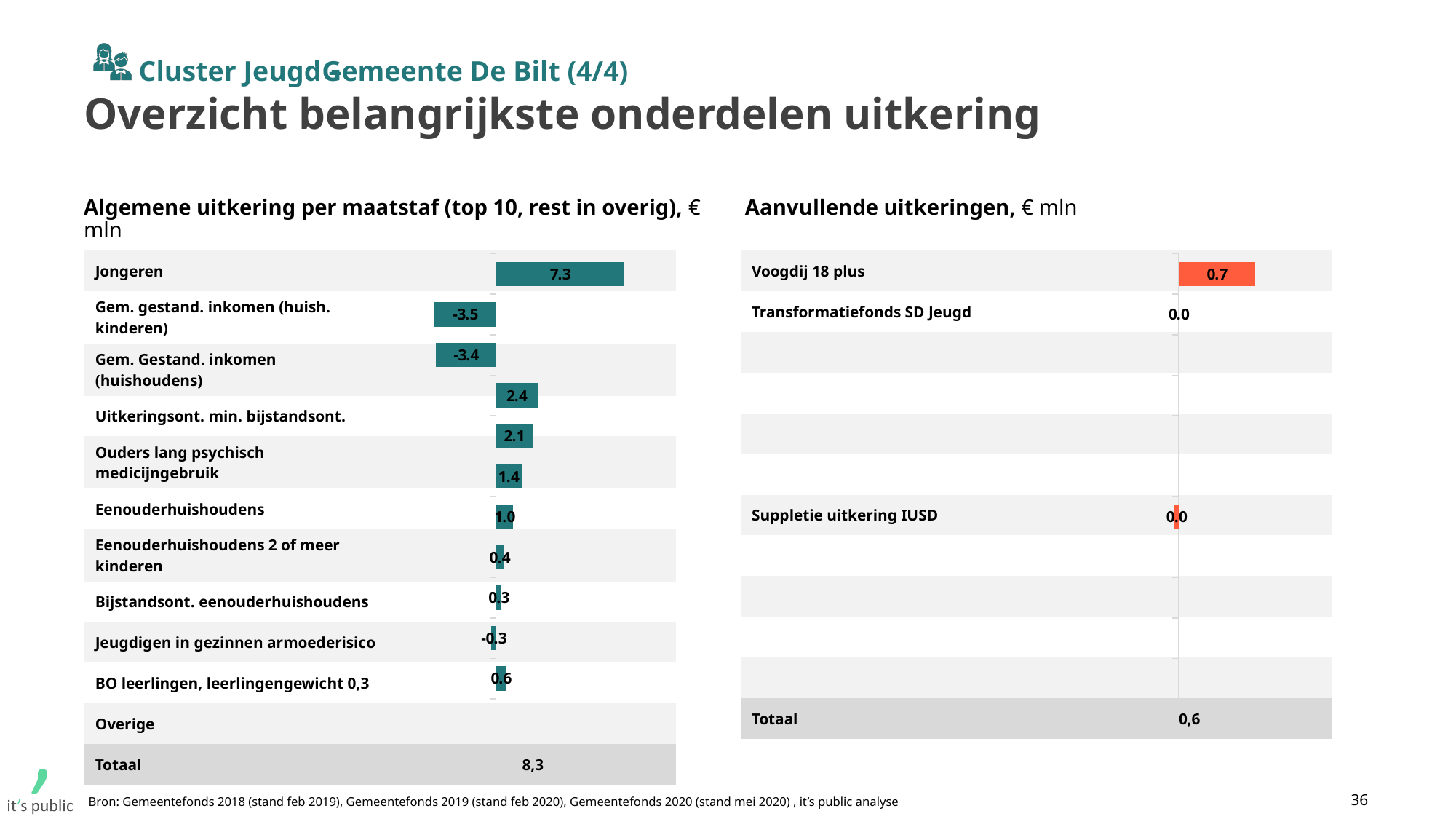
In the chart 'Algemene uitkering per maatstaf', what is the value for Gem. Gestand. inkomen (huishoudens)? -3.4 In the chart 'Algemene uitkering per maatstaf', which category has the lowest value? Gem. gestand. inkomen (huish. kinderen) In the chart 'Aanvullende uitkeringen', what is the value for Voogdij 18 plus? 0.7 In what unit are the values in the chart 'Aanvullende uitkeringen' expressed? € mln In the chart 'Algemene uitkering per maatstaf', which is larger: the value for Jongeren or the value for Ouders lang psychisch medicijngebruik? Jongeren In the chart 'Algemene uitkering per maatstaf', what is the difference between the value for Jongeren and the value for Uitkeringsont. min. bijstandsont.? 4.9 In the chart 'Algemene uitkering per maatstaf', what is the value for Jongeren? 7.3 In the chart 'Aanvullende uitkeringen', what is the Totaal value? 0,6 In the chart 'Aanvullende uitkeringen', what is the value for Transformatiefonds SD Jeugd? 0.0 In the chart 'Algemene uitkering per maatstaf', what is the Totaal value? 8,3 In the chart 'Algemene uitkering per maatstaf', which category has the highest value? Jongeren What kind of chart is 'Algemene uitkering per maatstaf'? Bar chart